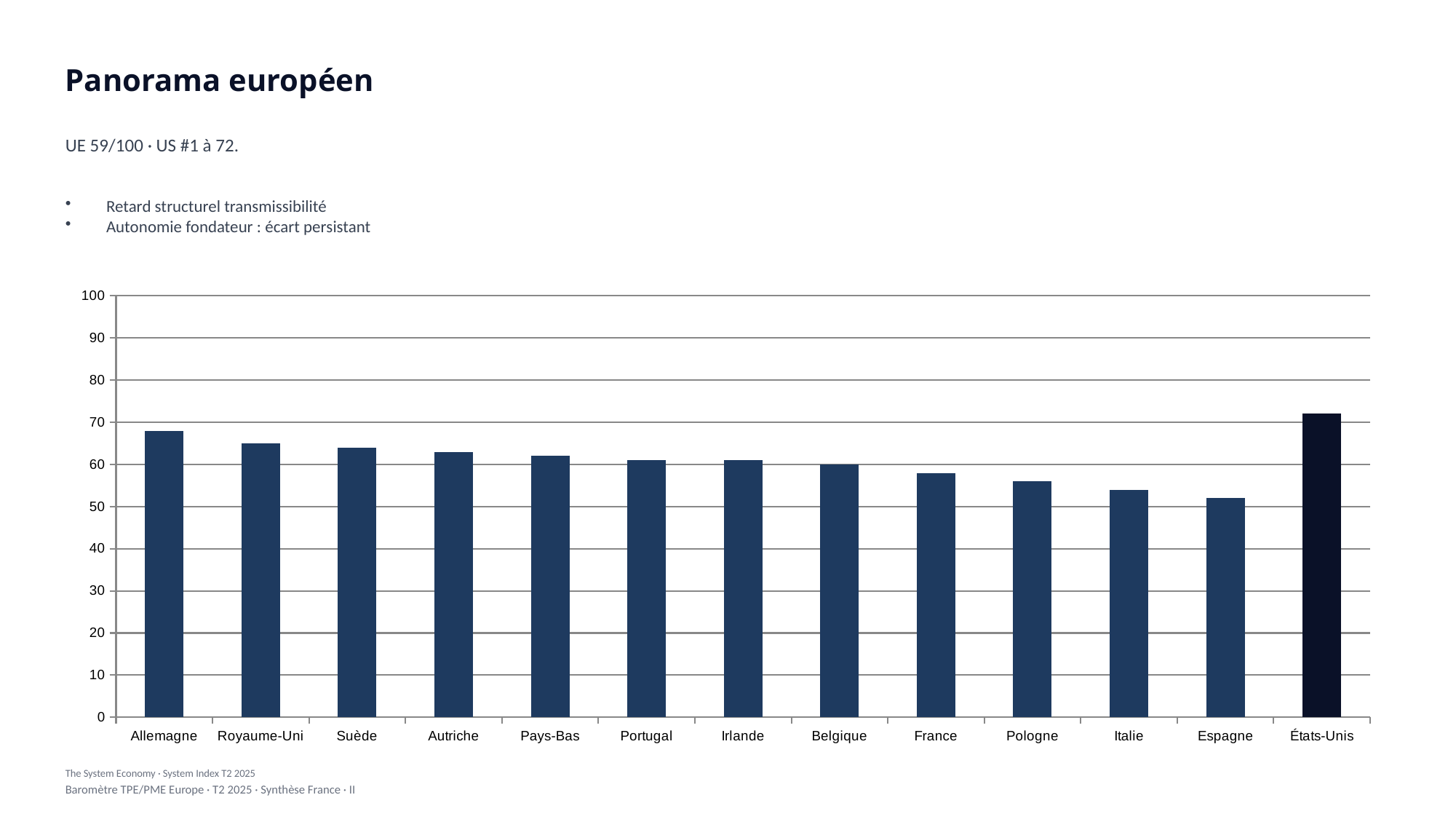
Is the value for Pays-Bas greater or less than 60? greater What kind of chart is shown on the slide? bar chart Which bar in the chart is drawn in a darker colour than the others? États-Unis What is the value for États-Unis in the chart? 72 Which has the larger value, Allemagne or Espagne? Allemagne Is the value for Espagne greater or less than 60? less How many countries are shown on the x axis of the chart? 13 Which country has the lowest bar in the chart? Espagne Is the value for Allemagne greater or less than 60? greater Which country has the highest bar in the chart? États-Unis Do the values for the European countries, from Allemagne to Espagne, rise or fall from left to right? fall